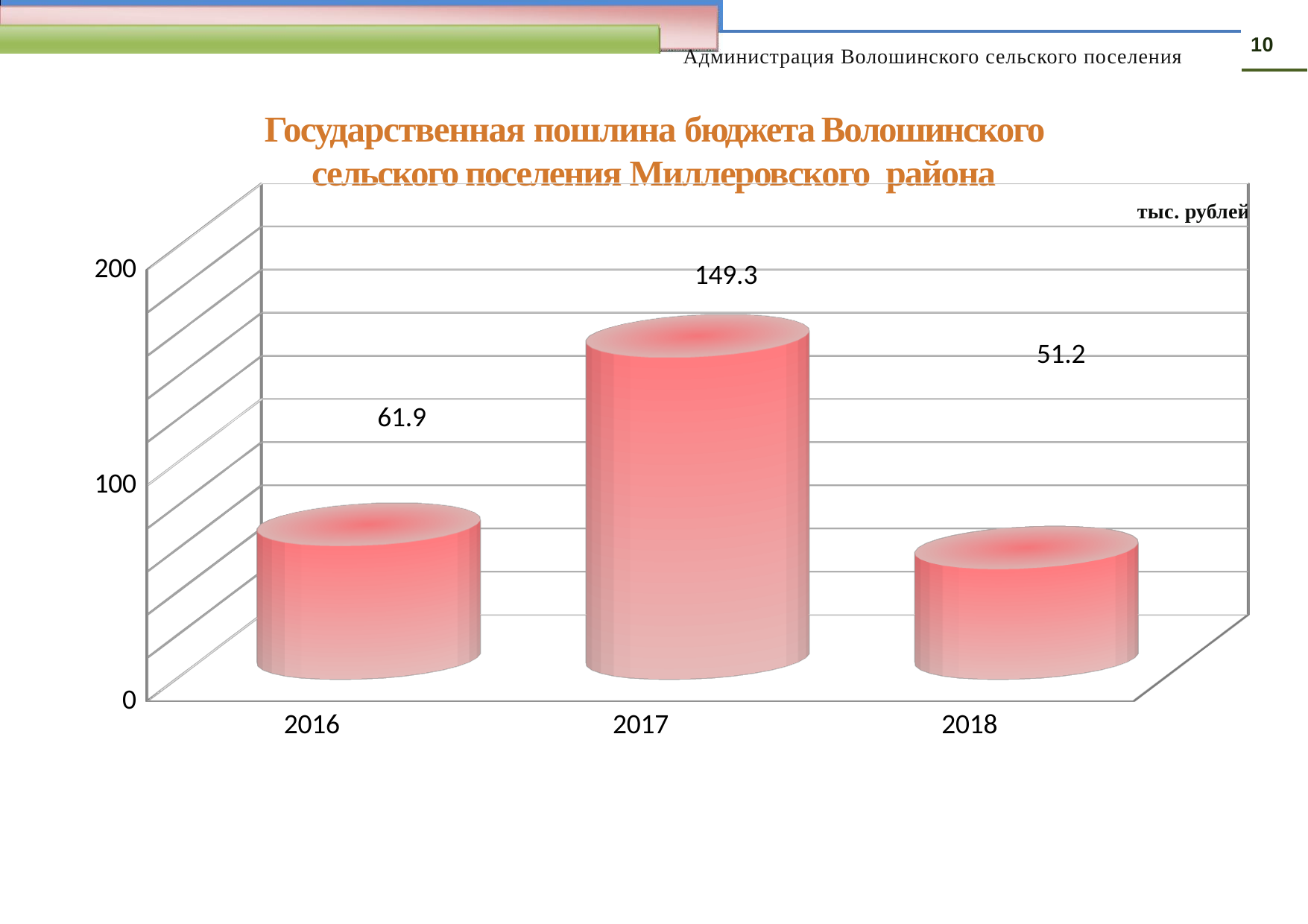
What is the difference between the values for 2016 and 2018? 10.7 Which is larger, the value for 2016 or the value for 2018? 2016 Which year has the highest value? 2017 What is the value for 2017? 149.3 Which year has the lowest value? 2018 What is the difference between the values for 2017 and 2016? 87.4 What unit of measurement is indicated on the chart? тыс. рублей How many years are shown on the chart? 3 What is the value for 2018? 51.2 What is the value for 2016? 61.9 Is the value for 2017 greater or less than 100? greater What kind of chart is shown on the slide? bar chart